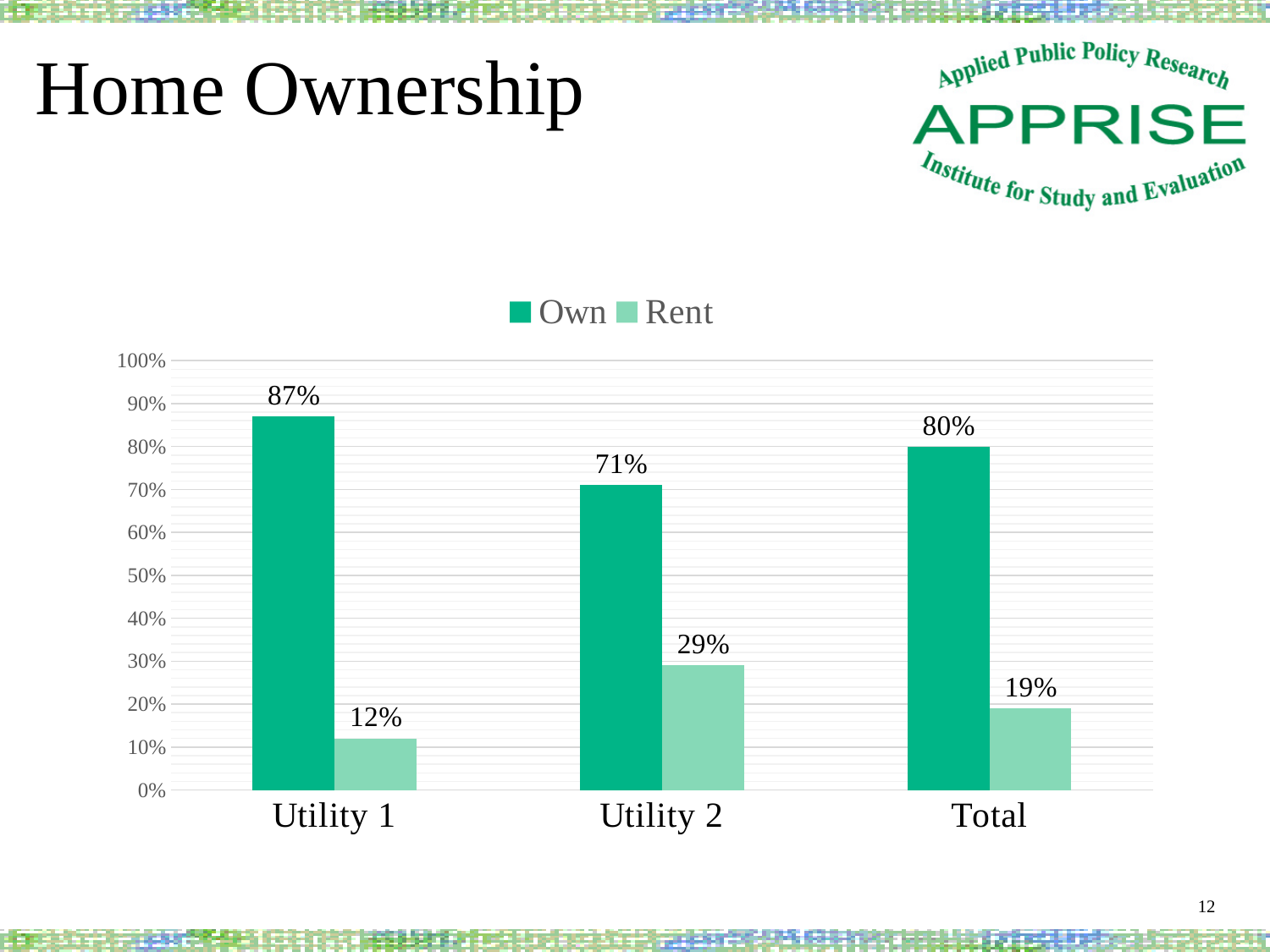
Which category has the highest Own value? Utility 1 Which category has the lowest Rent value? Utility 1 Which is larger, the Rent value for Utility 2 or the Rent value for Total? Utility 2 How many series does the legend list? 2 What is the Rent value for Utility 2? 29% What is the Own value for Utility 1? 87% What is the Rent value for Utility 1? 12% What kind of chart is shown on the slide? Bar chart What is the Own value for Total? 80% What is the difference between the Own values for Utility 1 and Utility 2? 16% How many categories are shown on the x axis? 3 What is the title of the slide containing the chart? Home Ownership